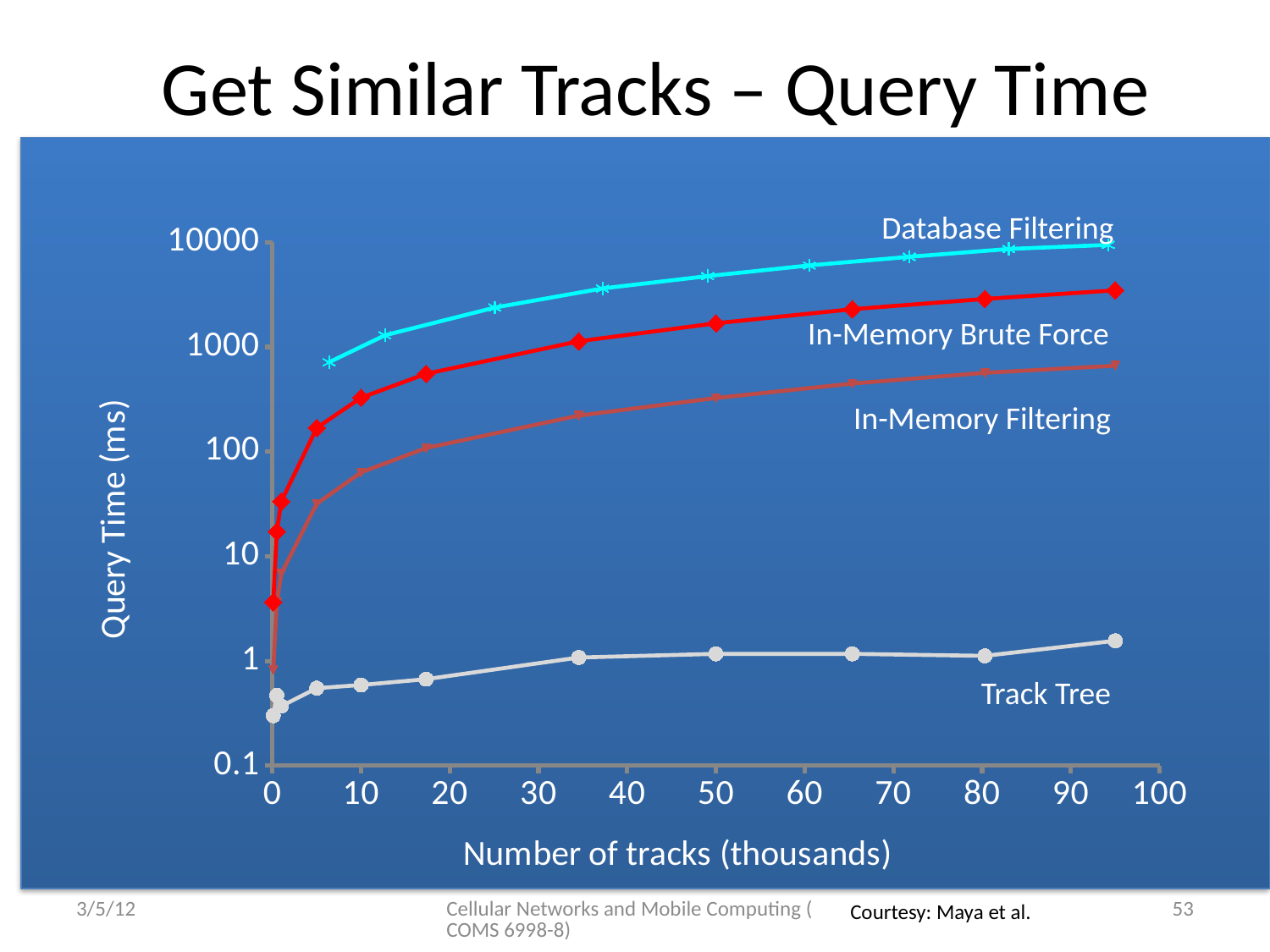
How many series are plotted on the chart? 4 Is the query time for In-Memory Brute Force at 95 thousand tracks greater or less than 1000 ms? greater Is the query time for Database Filtering at 50 thousand tracks greater or less than 1000 ms? greater Which series has the highest query time across the range of track counts? Database Filtering Is the query time for Track Tree at 95 thousand tracks greater or less than 10 ms? less What is the label of the y axis? Query Time (ms) What is the label of the x axis? Number of tracks (thousands) Does the query time for In-Memory Brute Force rise or fall as the number of tracks increases? rise What kind of chart is shown on the slide? line chart Which series has the lowest query time across the range of track counts? Track Tree At 50 thousand tracks, which has the larger query time: Database Filtering or In-Memory Brute Force? Database Filtering